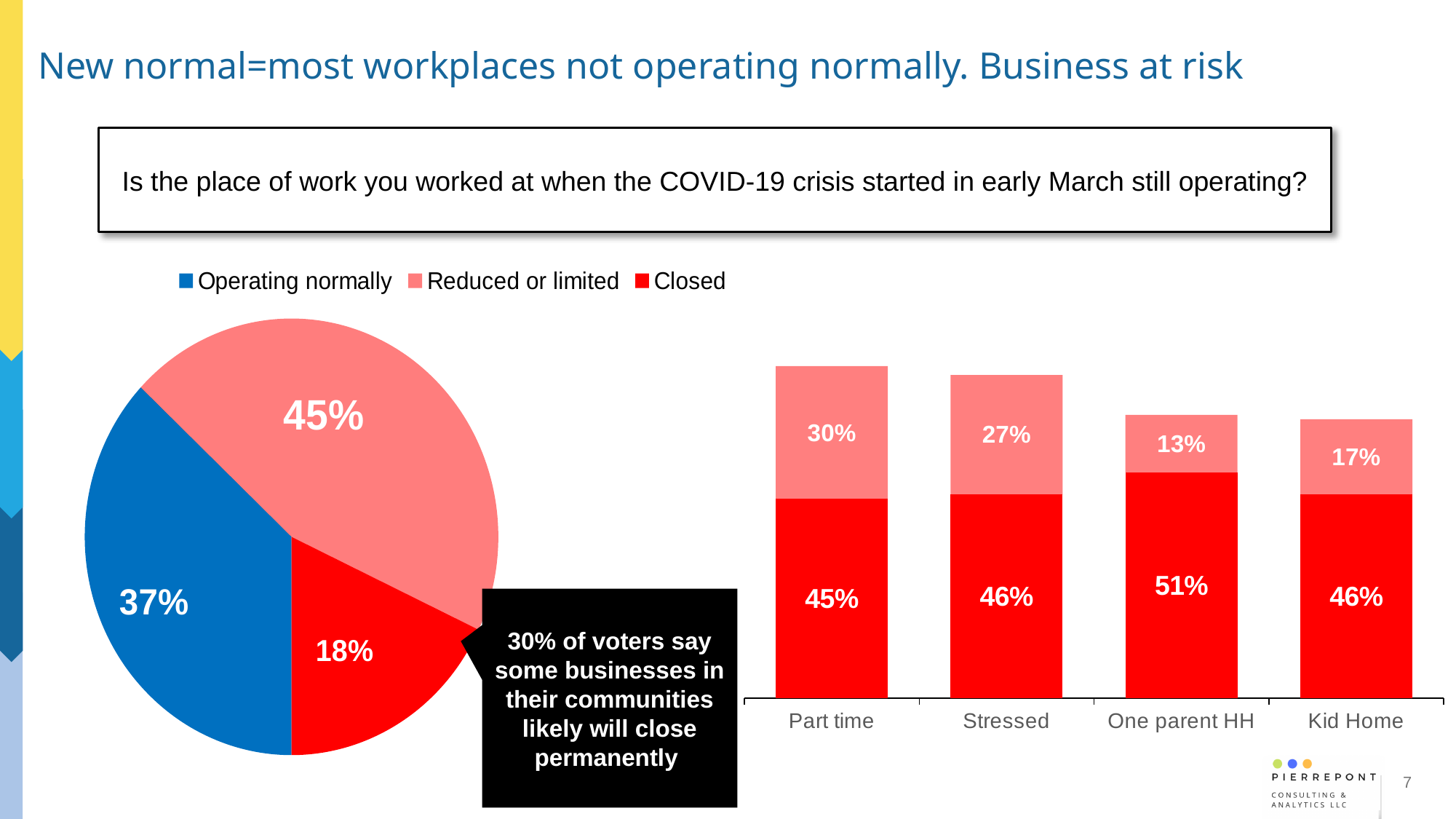
In the pie chart on the left, how many percentage points larger is the Reduced or limited slice than the Operating normally slice? 8 In the bar chart on the right, how many categories are shown on the x axis? 4 In the pie chart on the left, what share of respondents said their workplace is operating normally? 37% What kind of chart is on the right side of the slide? Stacked bar chart In the bar chart on the right, what is the value of the red (Closed) segment for One parent HH? 51% In the pie chart on the left, what percentage is shown for the Closed slice? 18% In the pie chart on the left, which category has the largest slice? Reduced or limited In the bar chart on the right, what is the total of the stacked bar for Stressed? 73% In the bar chart on the right, which category has the highest red (Closed) value? One parent HH How many series does the legend on the slide list? 3 In the pie chart on the left, which category has the smallest slice? Closed In the bar chart on the right, what is the value of the pink (Reduced or limited) segment for Part time? 30%